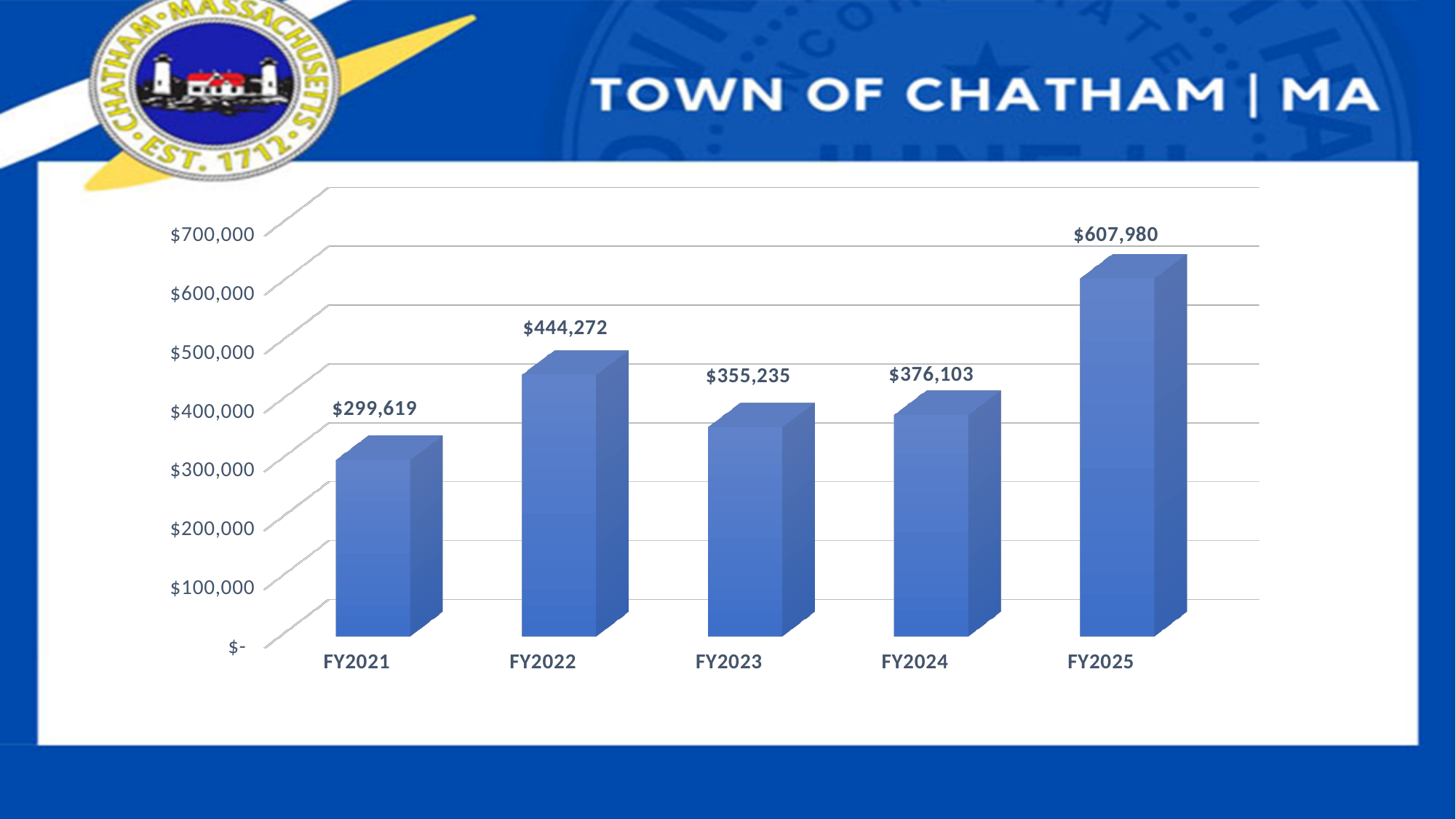
What is the value for FY2023? $355,235 What is the value for FY2025? $607,980 What is the value for FY2021? $299,619 Which fiscal year has the highest value? FY2025 Which fiscal year has the lowest value? FY2021 What is the highest value labelled on the y axis? $700,000 How many fiscal years are shown on the x axis? 5 What is the difference between the FY2025 and FY2024 values? $231,877 What kind of chart is shown on the slide? bar chart Is the value for FY2024 greater or less than $400,000? less What is the difference between the FY2022 and FY2021 values? $144,653 Which is larger, the value for FY2022 or the value for FY2023? FY2022